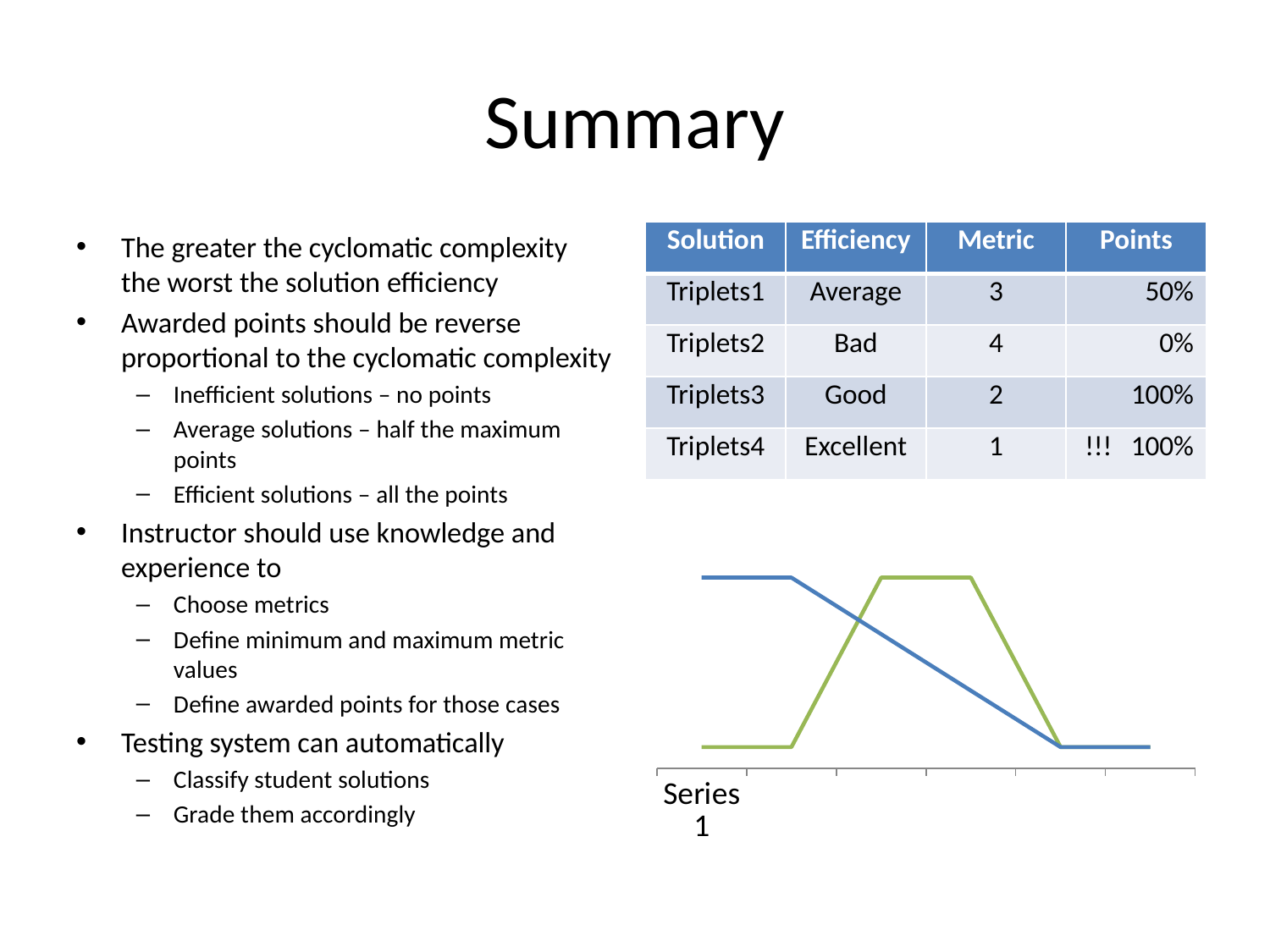
Does the blue line rise or fall from left to right across the chart? fall What kind of chart is shown on the slide? line chart What label is shown on the x axis of the chart? Series 1 In the middle of the chart, which line is higher, the blue or the green? green At the left end of the chart, which line is higher, the blue or the green? blue Does the chart display a legend? No How many lines are plotted on the chart? 2 What colours are the two lines on the chart? blue and green Which line on the chart rises and then falls again from left to right? the green line